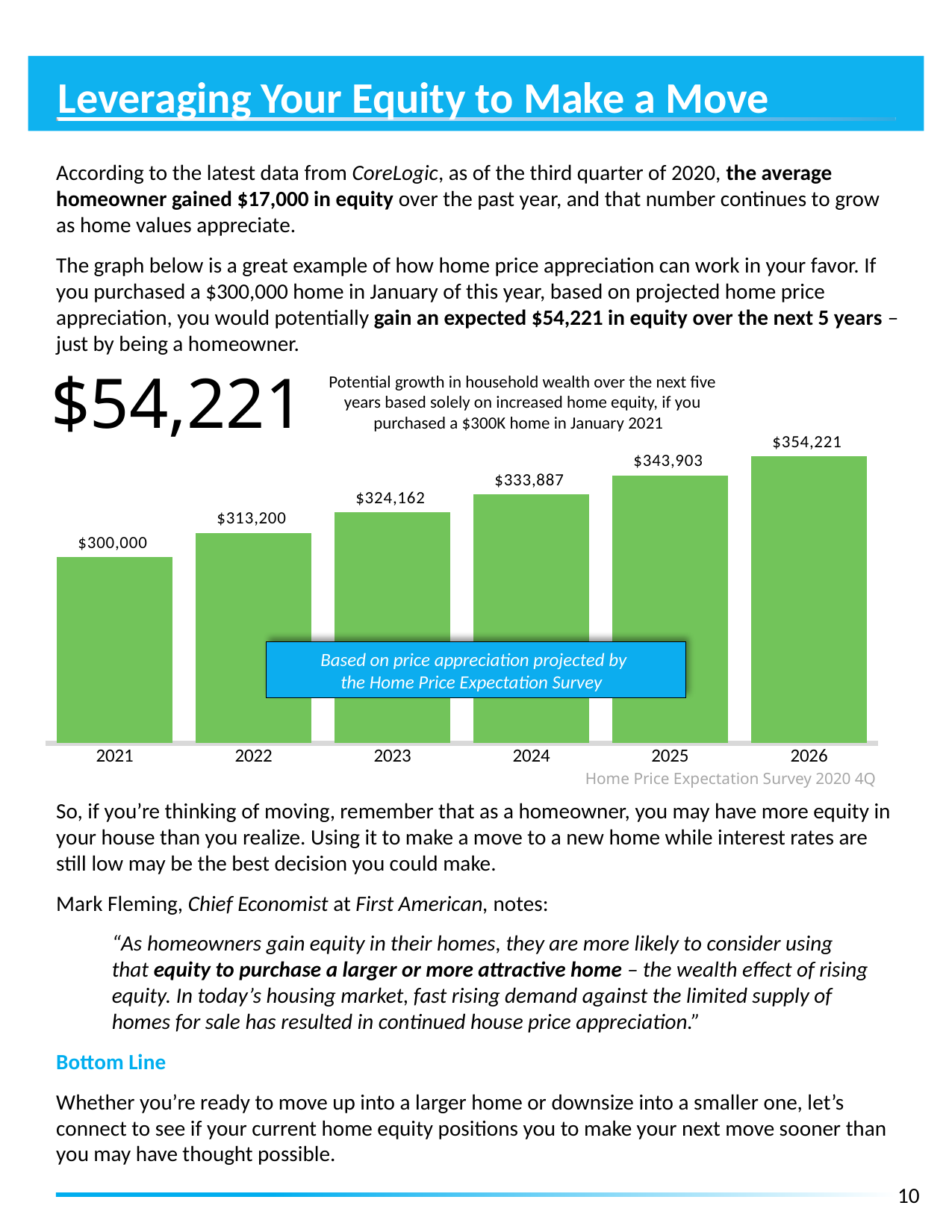
Which year has the lowest home value on the chart? 2021 What is the difference between the 2026 value and the 2021 value? $54,221 Do the values rise or fall from 2021 to 2026? Rise Which is larger, the value for 2025 or the value for 2023? 2025 What is the projected home value for 2024? $333,887 What kind of chart is shown on the slide? Bar chart How many years are shown on the x axis of the chart? 6 What source is cited below the chart? Home Price Expectation Survey 2020 4Q What is the difference between the 2023 value and the 2022 value? $10,962 What is the projected home value for 2026? $354,221 What is the value shown for 2021? $300,000 Which year has the highest projected home value? 2026